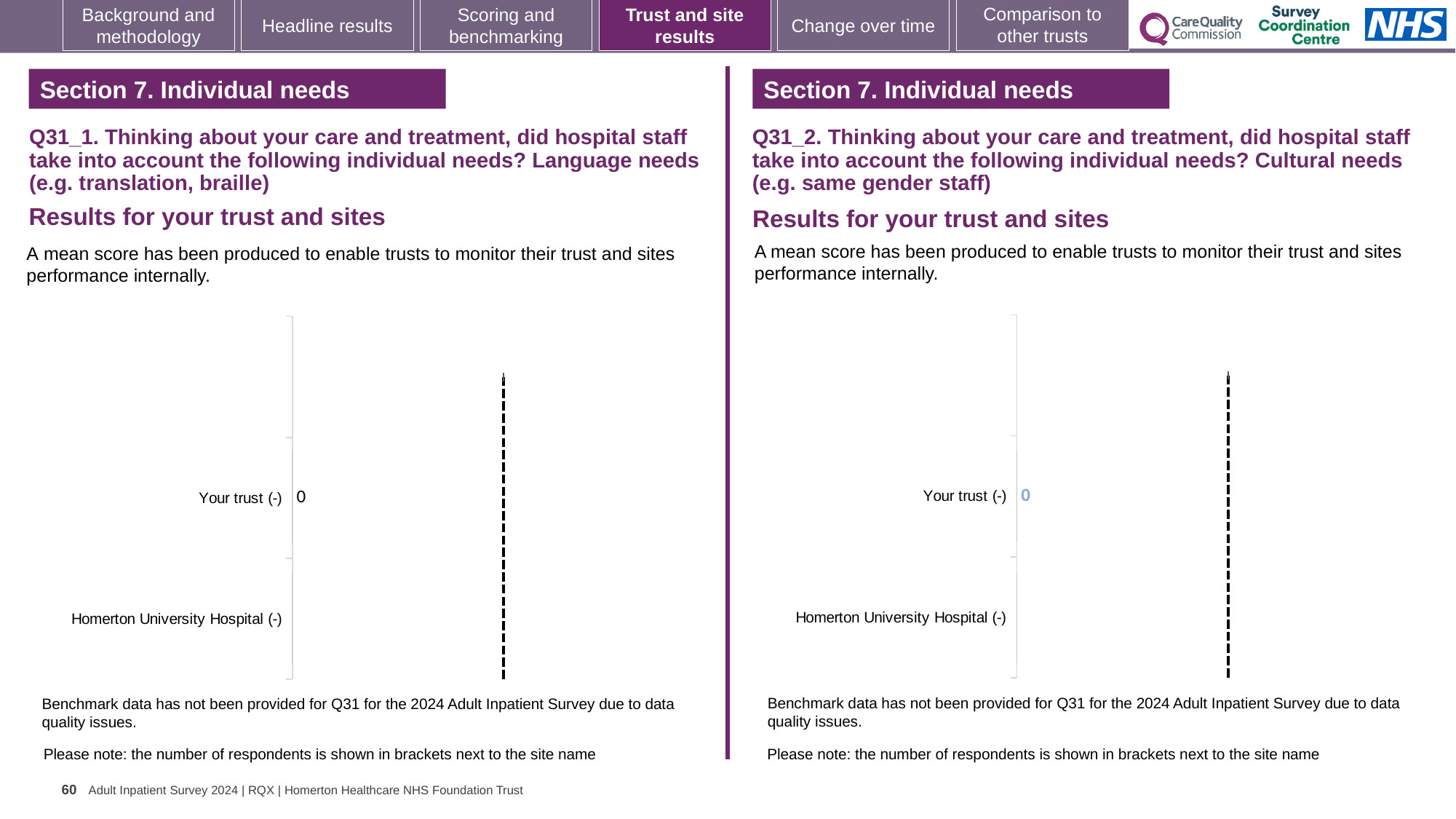
On the right chart (Q31_2, Cultural needs), how many categories are listed on the vertical axis? 2 Which individual need does the right chart's question Q31_2 ask about? Cultural needs (e.g. same gender staff) On the right chart (Q31_2, Cultural needs), what value is shown for Your trust? 0 On the left chart (Q31_1, Language needs), what value is shown for Your trust? 0 On the left chart (Q31_1, Language needs), how many categories are listed on the vertical axis? 2 On the left chart (Q31_1, Language needs), which site is listed below Your trust? Homerton University Hospital (-) What kind of chart is used on the left side of the slide for Q31_1? bar chart